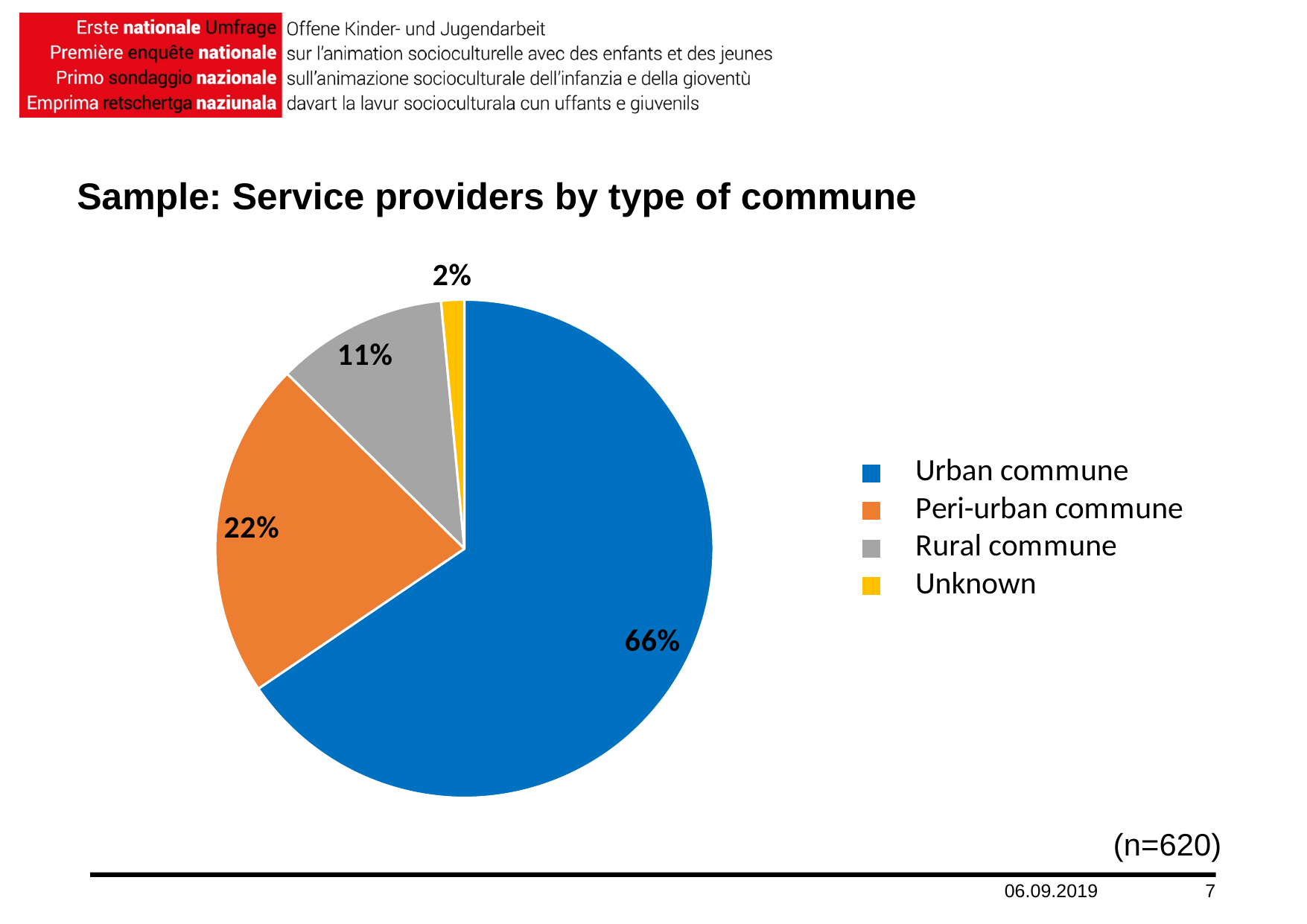
How many categories does the pie chart show? 4 Which colour represents rural communes in the pie chart? Grey What share of service providers are in urban communes? 66% What share of service providers are in peri-urban communes? 22% What is the title of the chart on the slide? Sample: Service providers by type of commune Which type of commune has the largest share of service providers? Urban commune What share of service providers are in rural communes? 11% What is the difference in percentage points between the urban commune share and the peri-urban commune share? 44 What share of service providers have an unknown type of commune? 2% Which is larger: the share for peri-urban communes or the share for rural communes? Peri-urban commune What kind of chart is shown on the slide? Pie chart Which category has the smallest share in the pie chart? Unknown